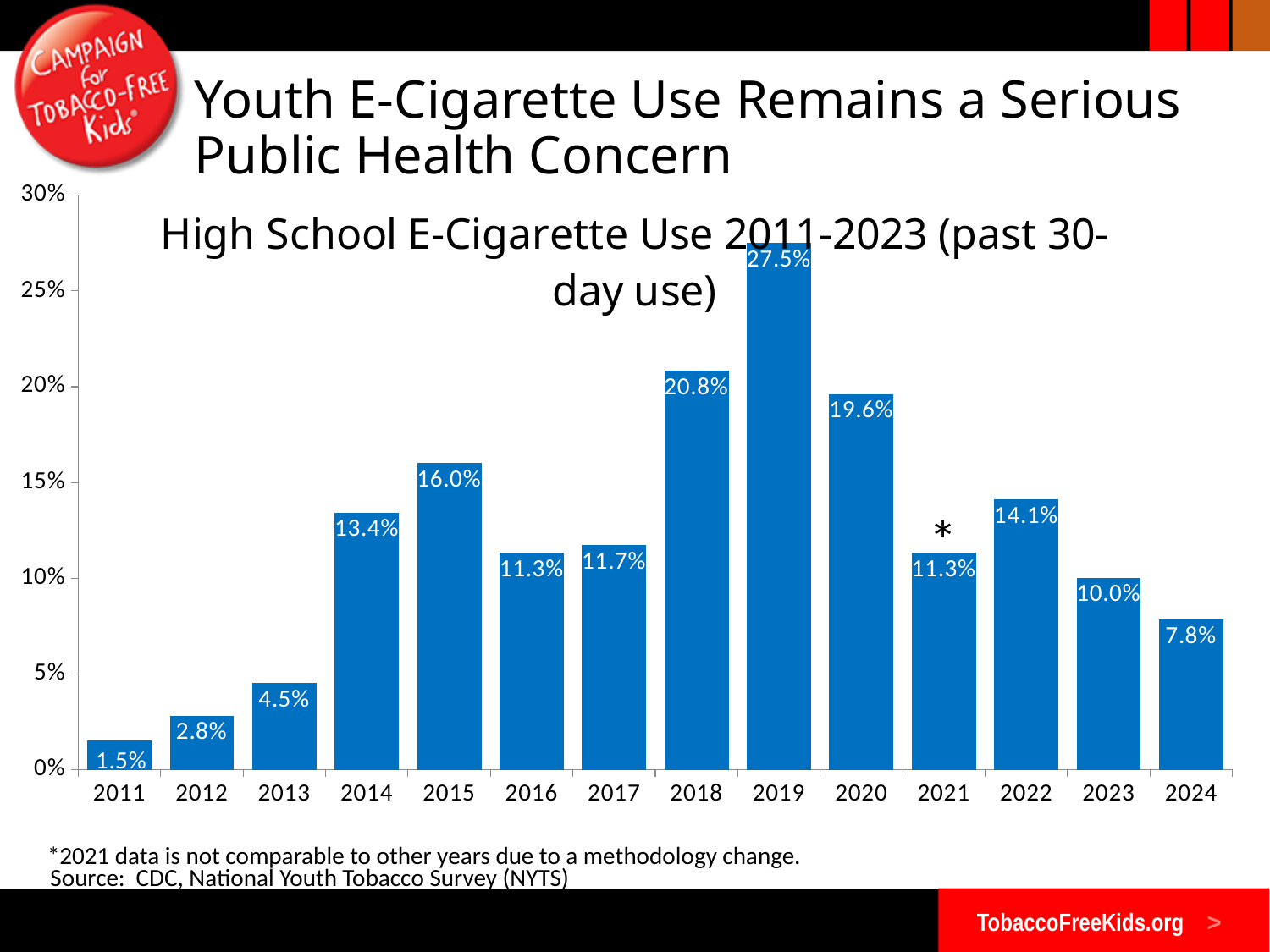
Is the value for 2018 greater or less than 20%? greater What is the value for 2019? 27.5% What is the value for 2014? 13.4% Which year has the lowest value? 2011 Which year has the highest value? 2019 What is the difference between the values for 2022 and 2023? 4.1% What kind of chart is this? bar chart What is the difference between the values for 2019 and 2020? 7.9% What is the value for 2024? 7.8% Which is larger, the value for 2015 or the value for 2016? 2015 Do the values rise or fall from 2019 to 2024? fall How many years are shown on the x axis? 14